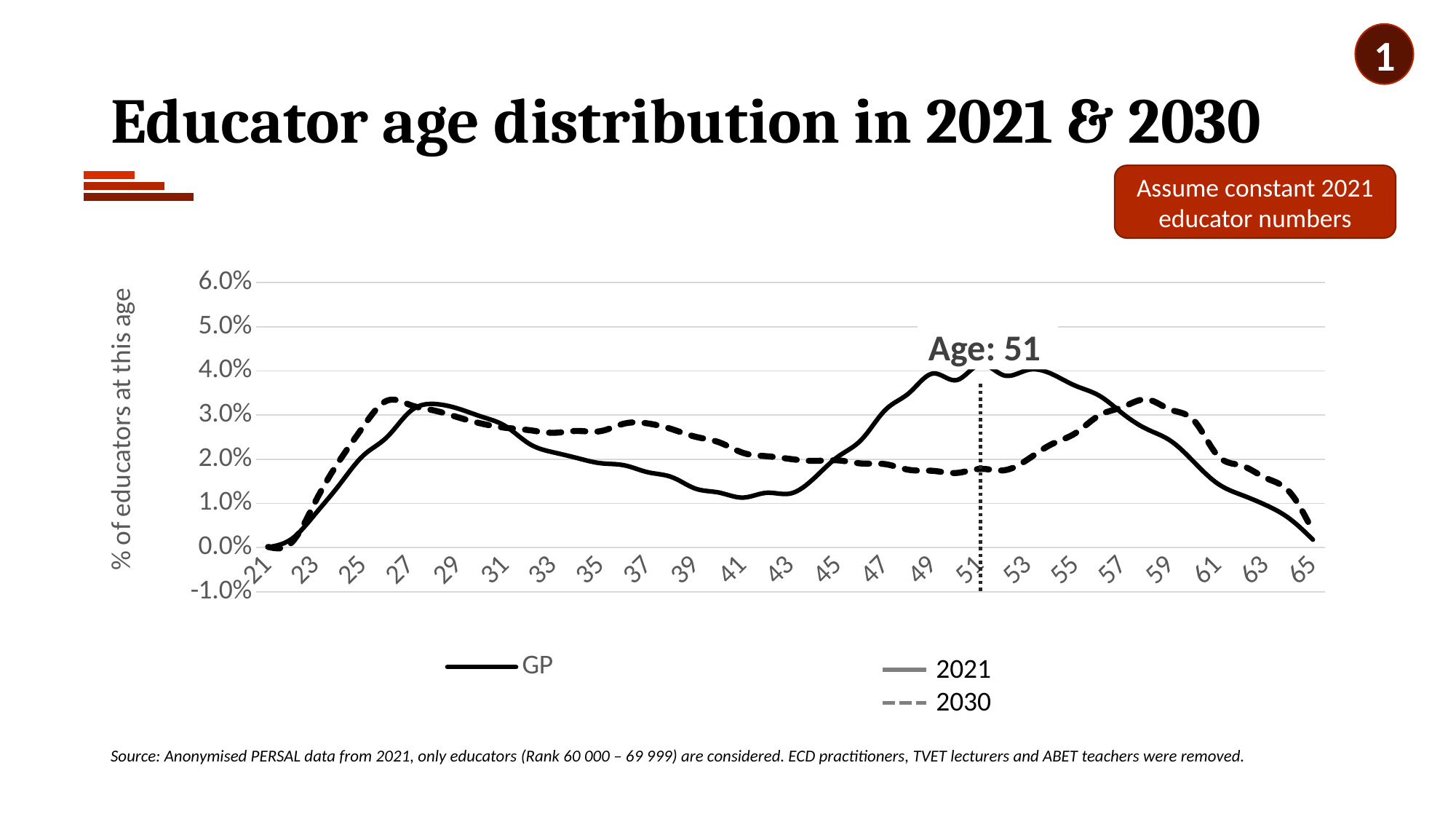
What is the label on the vertical axis of the chart? % of educators at this age At age 59, which line is higher, the solid 2021 line or the dashed 2030 line? 2030 What is the title of the chart on the slide? Educator age distribution in 2021 & 2030 Is the value of the solid 2021 line at age 51 greater or less than 3.0%? greater Is the value of the dashed 2030 line at age 51 greater or less than 2.0%? less At age 37, which line is higher, the solid 2021 line or the dashed 2030 line? 2030 Is the value of the solid 2021 line at age 65 greater or less than 1.0%? less What kind of chart is shown on the slide? line chart Does the solid 2021 line rise or fall between age 53 and age 65? fall At age 51, which line is higher, the solid 2021 line or the dashed 2030 line? 2021